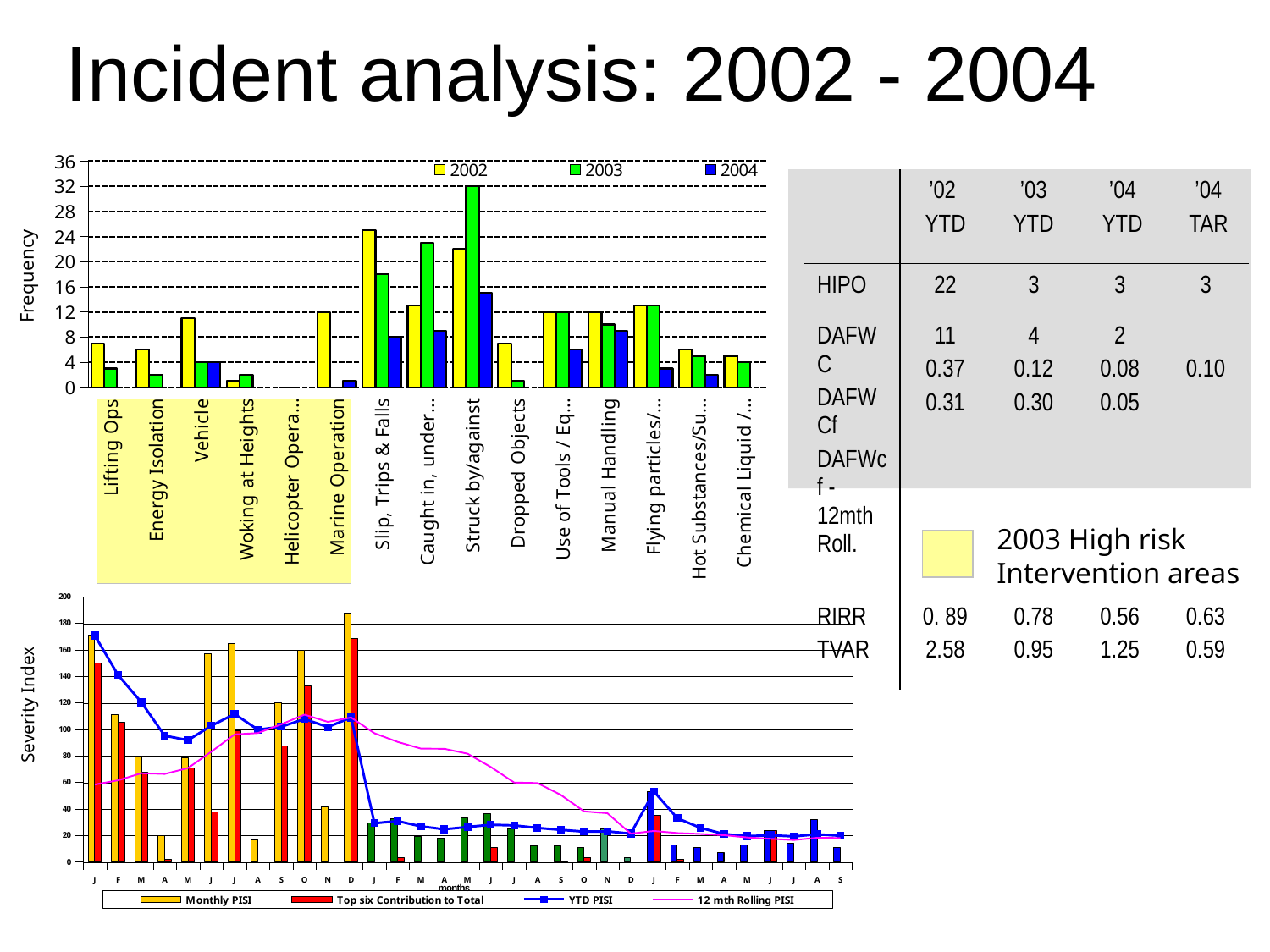
In the bottom Severity Index chart, does the YTD PISI line generally rise or fall from left to right? fall In the top Frequency chart, how many series does the legend list? 3 In the top Frequency chart, which is larger for Vehicle: the 2002 bar or the 2003 bar? 2002 In the top Frequency chart, which years are listed in the legend? 2002, 2003, 2004 In the top Frequency chart, is the 2003 value for Caught in, under... greater or less than 20? greater In the top Frequency chart, what is the 2003 value for Struck by/against? 32 In the top Frequency chart, how many incident categories are shown on the x axis? 15 What is the y-axis label of the bottom chart? Severity Index In the bottom Severity Index chart, how many series does the legend list? 4 In the top Frequency chart, is the 2002 value for Slip, Trips & Falls greater or less than 24? greater In the top Frequency chart, which category has the tallest 2002 bar? Slip, Trips & Falls In the top Frequency chart, which category has the tallest bar overall? Struck by/against